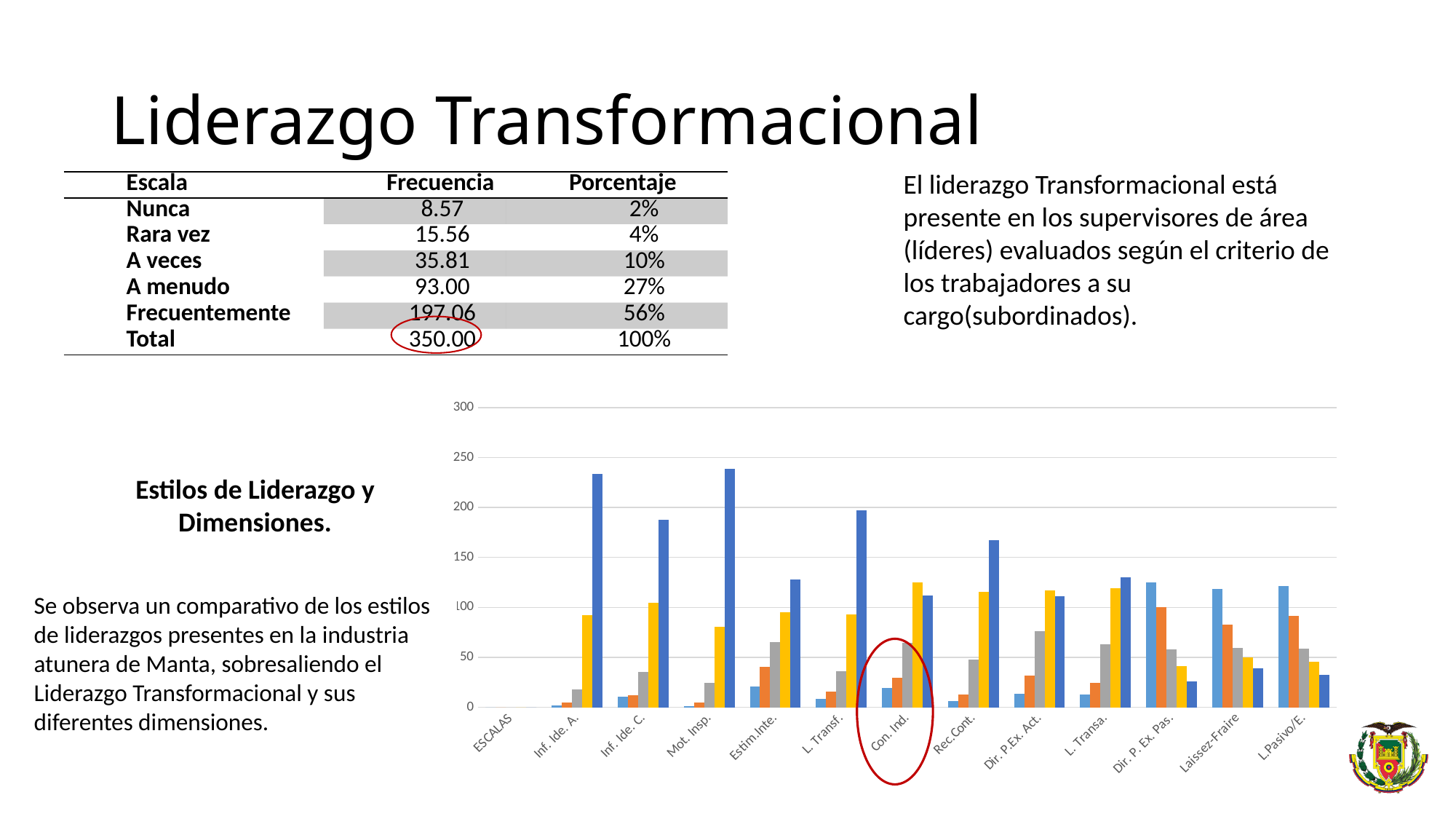
In the bar chart, which has the taller yellow bar, Con. Ind. or L. Transf.? Con. Ind. In the bar chart, is the dark blue bar for Inf. Ide. C. greater or less than 200? less How many category labels are shown along the x axis of the bar chart? 13 In the bar chart, is the orange bar for Laissez-Faire greater or less than 100? less Which category in the bar chart is circled in red? Con. Ind. What kind of chart is shown at the bottom of the slide? bar chart In the bar chart, is the yellow bar for Inf. Ide. A. greater or less than 100? less In the bar chart, which has the taller dark blue bar, Inf. Ide. A. or Inf. Ide. C.? Inf. Ide. A.